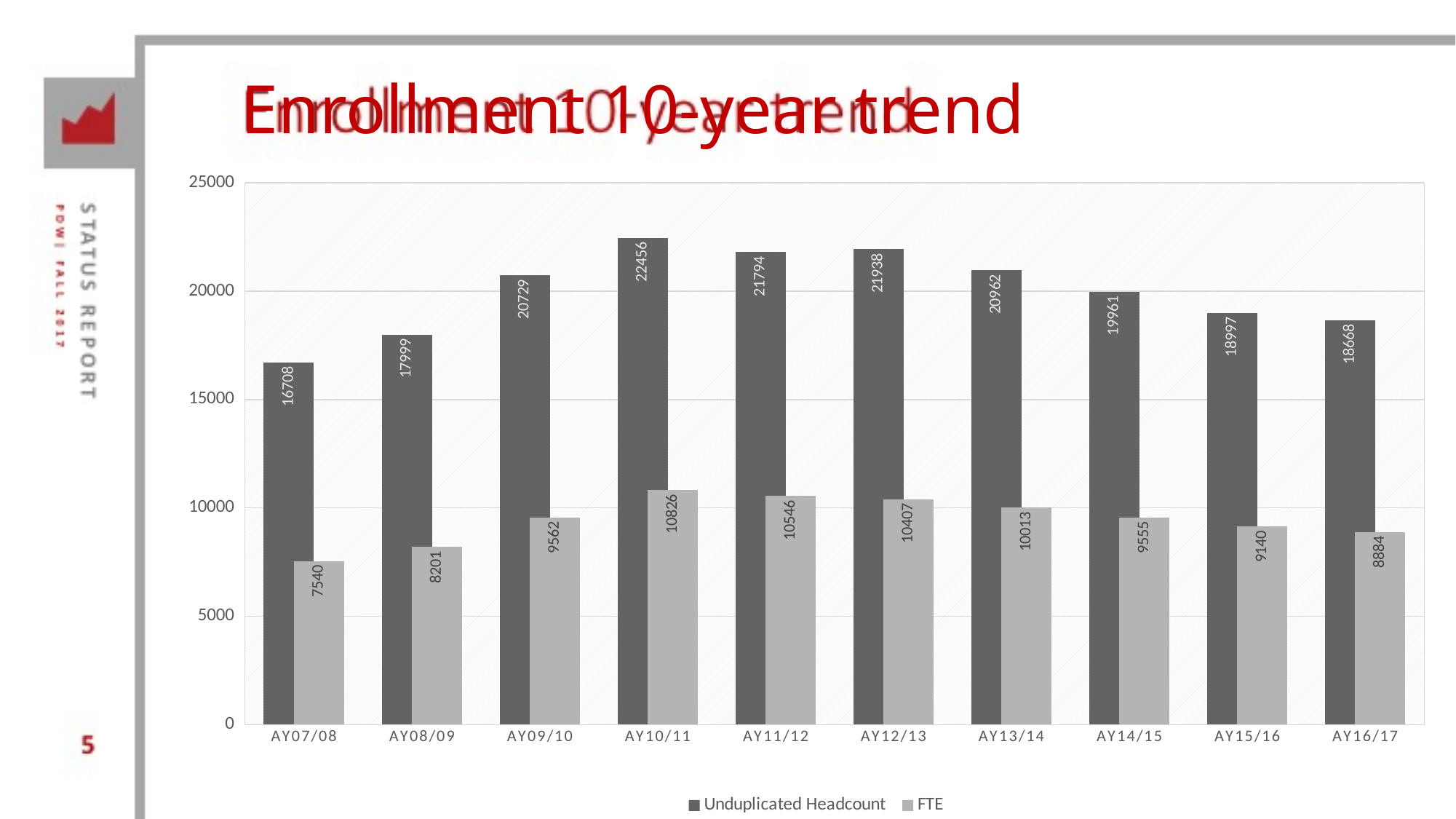
Which is larger, the FTE for AY09/10 or the FTE for AY14/15? AY09/10 Does the Unduplicated Headcount rise or fall from AY12/13 to AY16/17? fall How many series does the legend list? 2 What is the FTE value for AY07/08? 7540 What kind of chart is shown on the slide? bar chart What is the difference between the Unduplicated Headcount and FTE in AY12/13? 11531 How many academic years are shown on the x axis? 10 What is the Unduplicated Headcount for AY10/11? 22456 What is the FTE value for AY16/17? 8884 Which academic year has the highest Unduplicated Headcount? AY10/11 Which academic year has the lowest FTE? AY07/08 Is the Unduplicated Headcount for AY08/09 greater or less than 20000? less